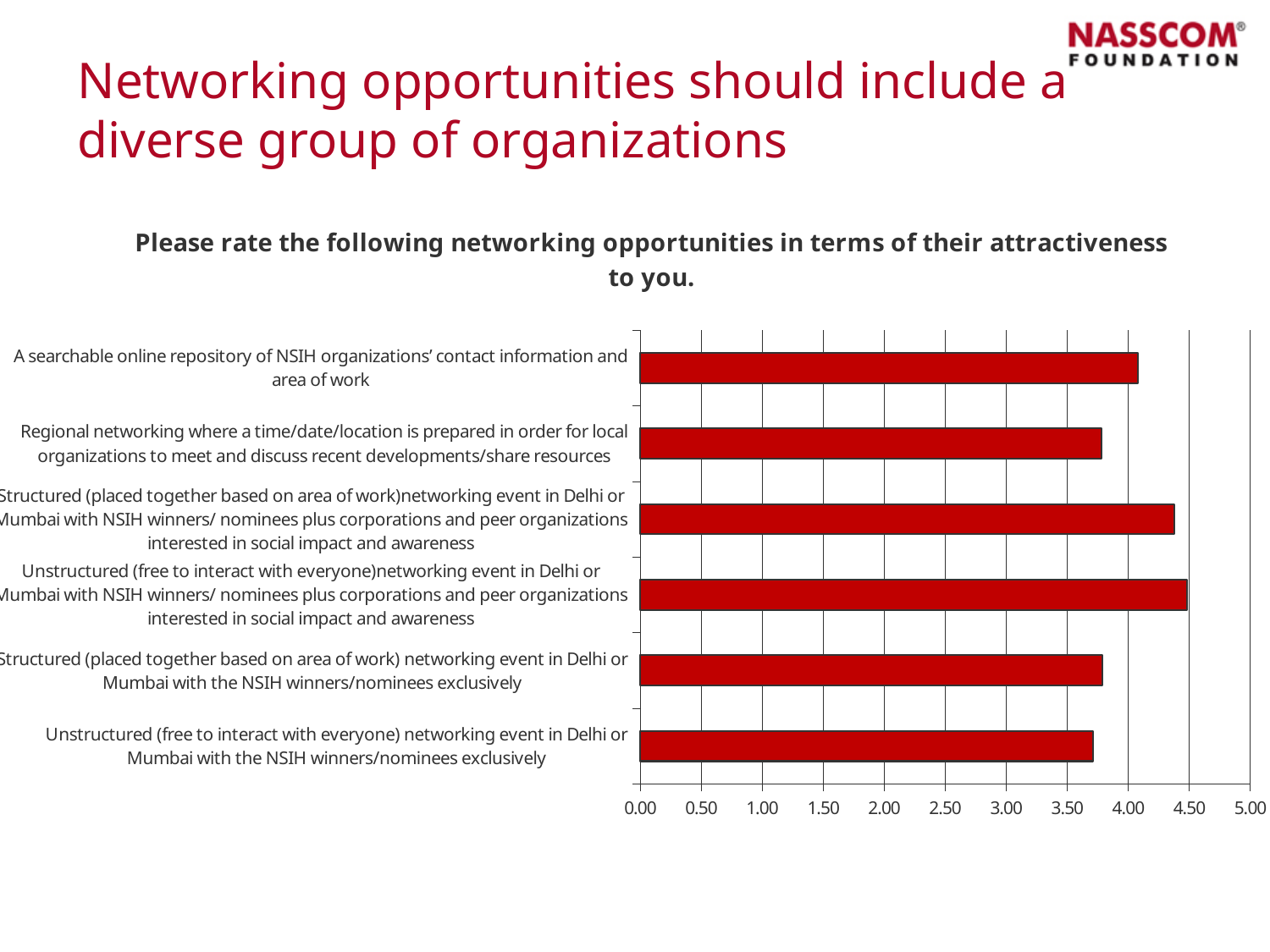
Is the value for 'A searchable online repository of NSIH organizations' contact information and area of work' greater or less than 4.00? greater What is the title of the chart? Please rate the following networking opportunities in terms of their attractiveness to you. Is the value for the structured networking event with the NSIH winners/nominees exclusively greater or less than 3.50? greater Is the value for the unstructured networking event with the NSIH winners/nominees exclusively greater or less than 4.00? less Which is rated higher: the structured networking event with NSIH winners/nominees plus corporations and peer organizations, or the structured networking event with the NSIH winners/nominees exclusively? Structured networking event with NSIH winners/ nominees plus corporations and peer organizations Which is rated higher: the searchable online repository of NSIH organizations' contact information, or the regional networking opportunity? A searchable online repository of NSIH organizations' contact information and area of work Which networking opportunity received the highest rating in the chart? Unstructured (free to interact with everyone) networking event in Delhi or Mumbai with NSIH winners/ nominees plus corporations and peer organizations interested in social impact and awareness How many networking opportunities (categories) are plotted in the chart? 6 What is the maximum value shown on the horizontal axis of the chart? 5.00 What kind of chart is shown on the slide? Bar chart